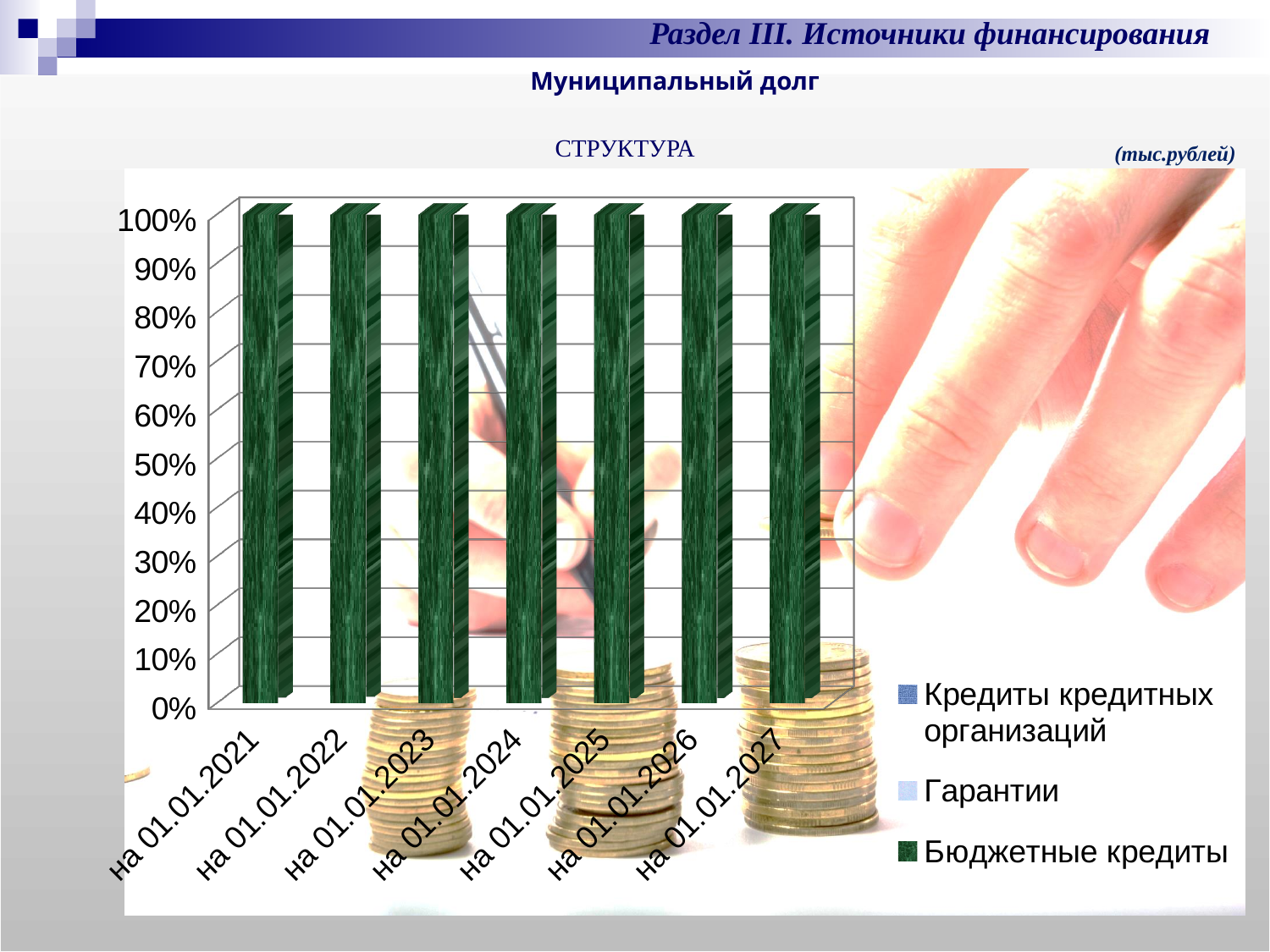
Does the share of Бюджетные кредиты rise, fall or stay the same from на 01.01.2021 to на 01.01.2027? stays the same How many dates (categories) are shown along the x axis of the chart? 7 Is the value for Бюджетные кредиты at на 01.01.2024 greater or less than 50%? greater What share of the bar for на 01.01.2027 is taken by Бюджетные кредиты? 100% How many series does the chart legend list? 3 What is the title shown above the chart? СТРУКТУРА What share of the bar for на 01.01.2021 is taken by Бюджетные кредиты? 100% What is the highest tick value shown on the y axis? 100% Which legend entry is shown in dark green? Бюджетные кредиты What is the first category label on the x axis? на 01.01.2021 What is the last category label on the x axis? на 01.01.2027 What kind of chart is shown on the slide? bar chart